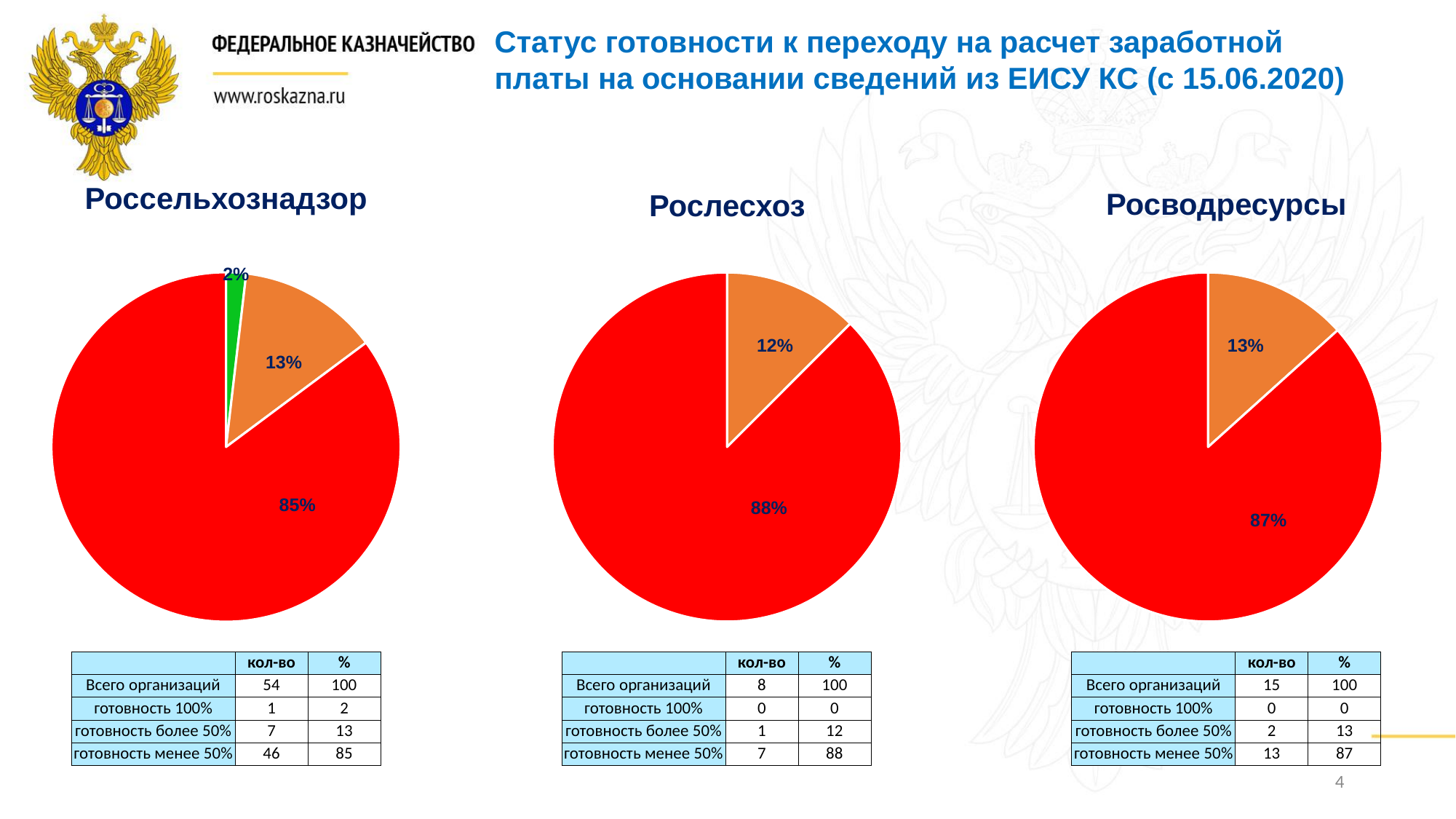
In the Россельхознадзор pie chart, what is the value of the smallest slice? 2% How many slices does the Россельхознадзор pie chart have? 3 What kind of chart is used for Рослесхоз? pie chart In the Рослесхоз pie chart, what value is shown on the orange slice? 12% In the Росводресурсы pie chart, what value is shown on the red slice? 87% In the Рослесхоз pie chart, what colour is the largest slice? red In the Россельхознадзор pie chart, which is larger: the orange slice or the green slice? the orange slice In the Росводресурсы pie chart, what share of the pie does the orange slice represent? 13% How many slices does the Рослесхоз pie chart have? 2 How many pie charts are shown on the slide? 3 In the Россельхознадзор pie chart, what is the difference between the red slice (85%) and the orange slice (13%)? 72 percentage points In the Россельхознадзор pie chart, what is the value of the largest slice? 85%